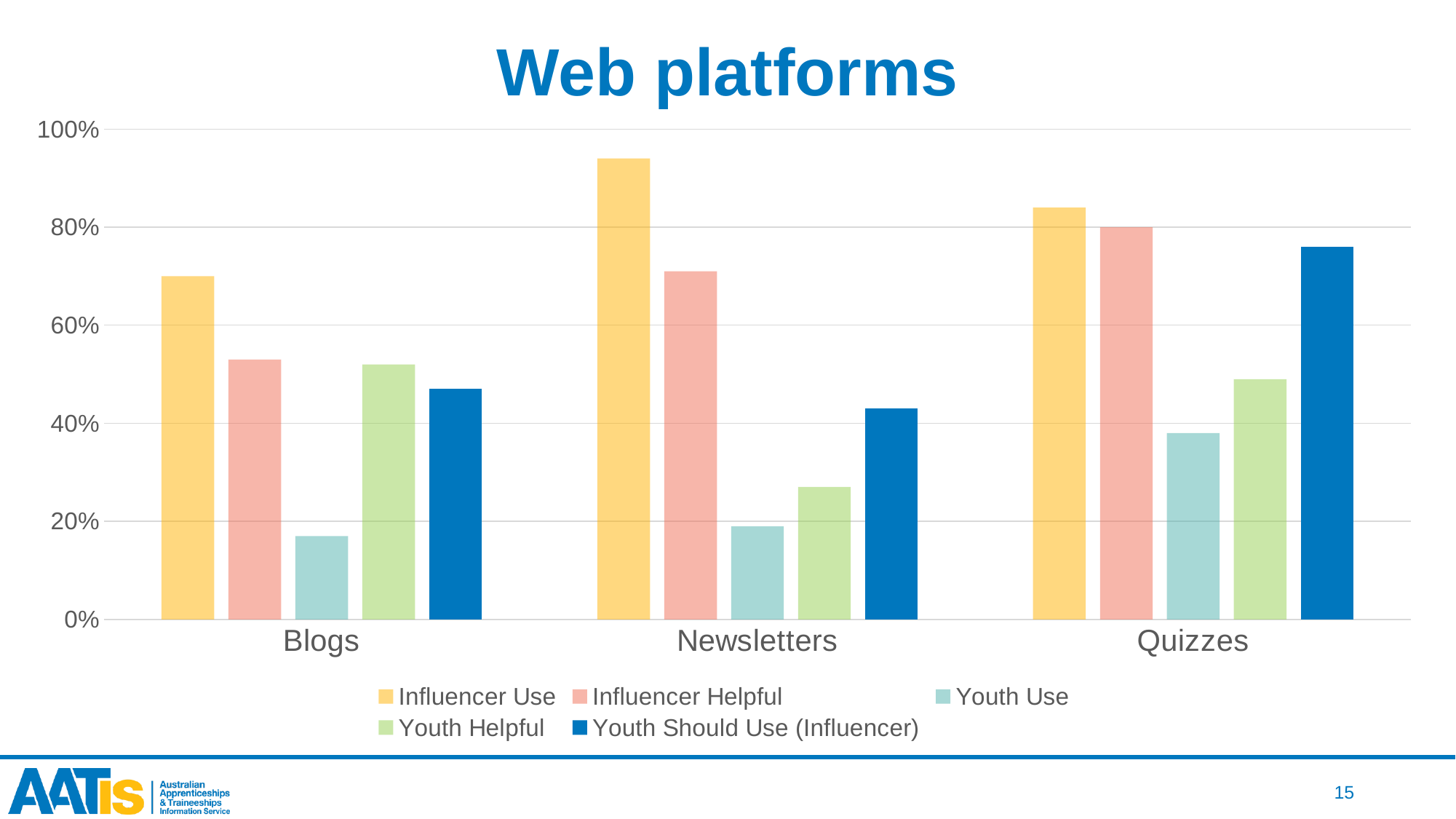
How many categories are shown on the x axis? 3 Is the Youth Should Use (Influencer) value for Quizzes greater or less than 60%? greater What kind of chart is shown on the slide? Bar chart What is the title of the chart? Web platforms Which category has the lowest Youth Helpful value? Newsletters Does the Youth Use value rise or fall from Blogs to Quizzes? rise Which category has the highest Influencer Use value? Newsletters Within the Newsletters category, which series has the lowest value? Youth Use How many series does the legend list? 5 Is the Influencer Use value for Newsletters greater or less than 80%? greater Is the Youth Use value for Blogs greater or less than 20%? less Which is larger: Influencer Use for Blogs or Influencer Use for Newsletters? Newsletters